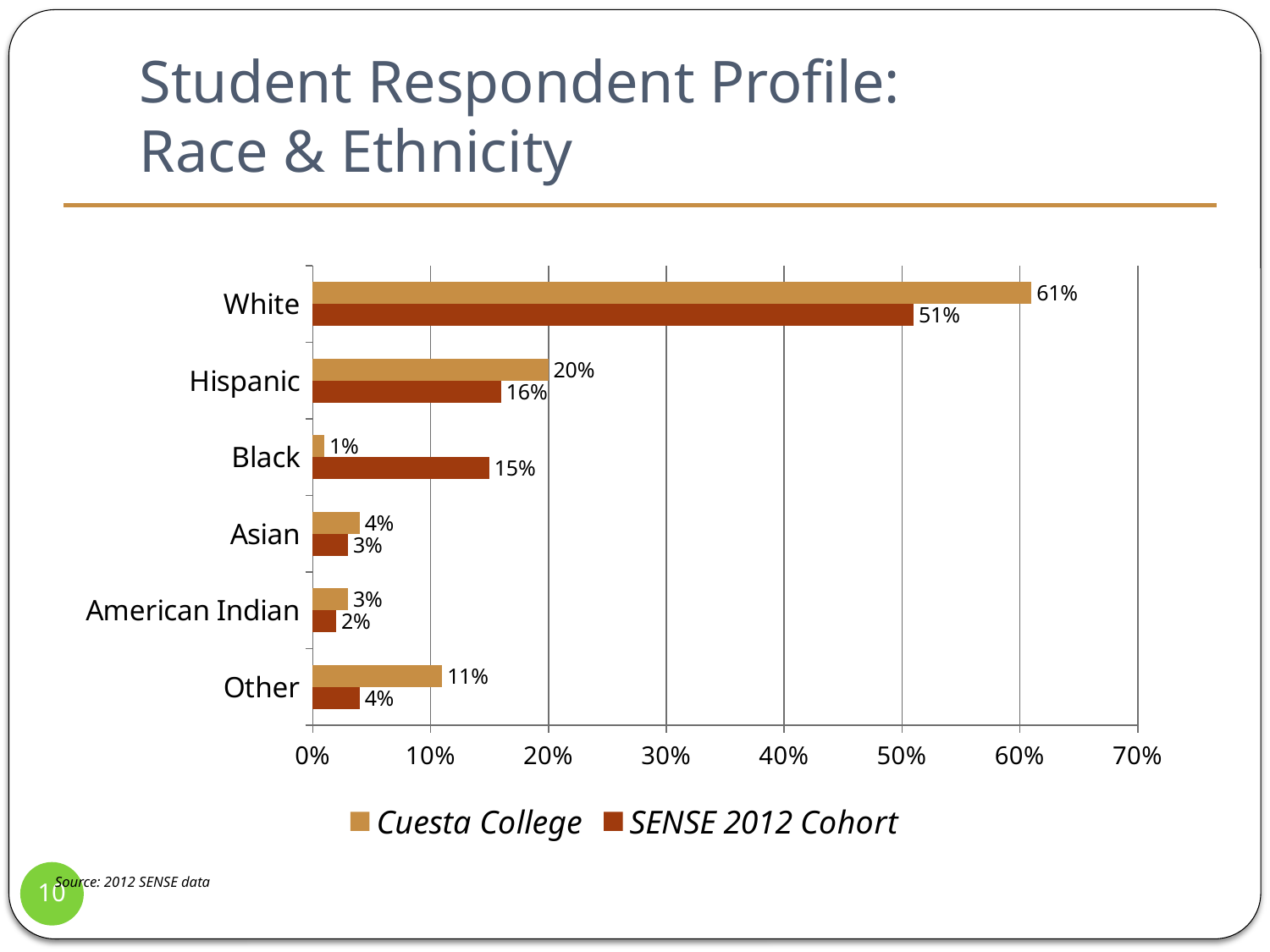
Which is larger for Other: the Cuesta College value or the SENSE 2012 Cohort value? Cuesta College Is the SENSE 2012 Cohort value for White greater or less than 40%? greater What is the Cuesta College value for Other? 11% Which category has the lowest Cuesta College value? Black What is the SENSE 2012 Cohort value for Black? 15% Which category has the highest SENSE 2012 Cohort value? White What is the difference between the Cuesta College and SENSE 2012 Cohort values for Hispanic? 4% What kind of chart is shown on the slide? Bar chart What is the difference between the SENSE 2012 Cohort and Cuesta College values for Black? 14% How many race/ethnicity categories are shown on the chart? 6 What is the Cuesta College value for White? 61% How many series does the legend list? 2